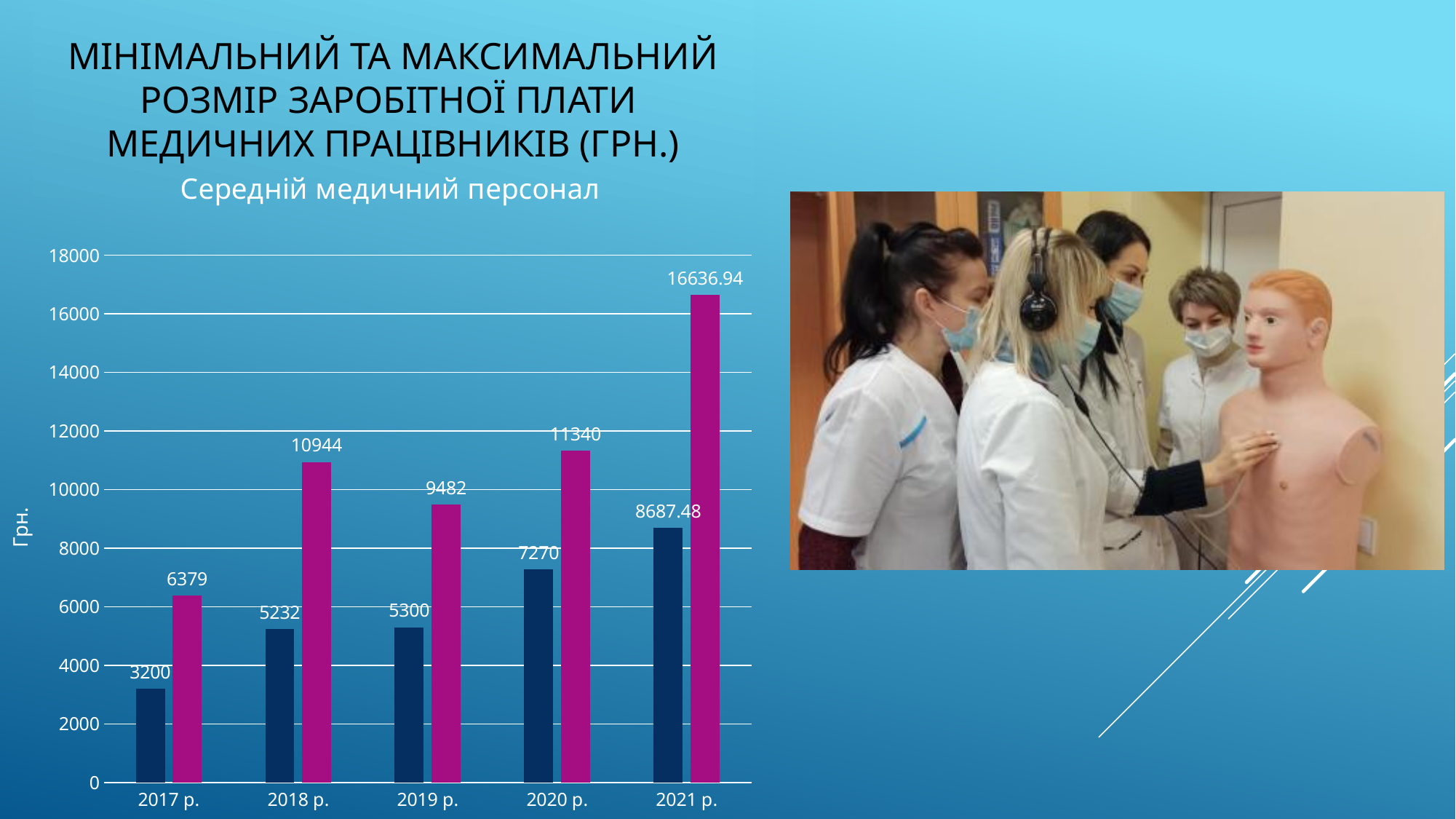
What is the difference between the magenta and dark blue bars for 2020 р.? 4070 What is the label on the vertical axis of the chart? Грн. Do the dark blue bars rise or fall from 2017 р. to 2021 р.? Rise What kind of chart is shown on the slide? Bar chart What is the value of the magenta bar for 2019 р.? 9482 What is the value of the dark blue bar for 2017 р.? 3200 In which year is the magenta bar the highest? 2021 р. How many years are shown on the x axis? 5 In which year is the dark blue bar the lowest? 2017 р. Which year has the larger magenta bar, 2018 р. or 2019 р.? 2018 р. What is the value of the dark blue bar for 2021 р.? 8687.48 What is the value of the magenta bar for 2021 р.? 16636.94